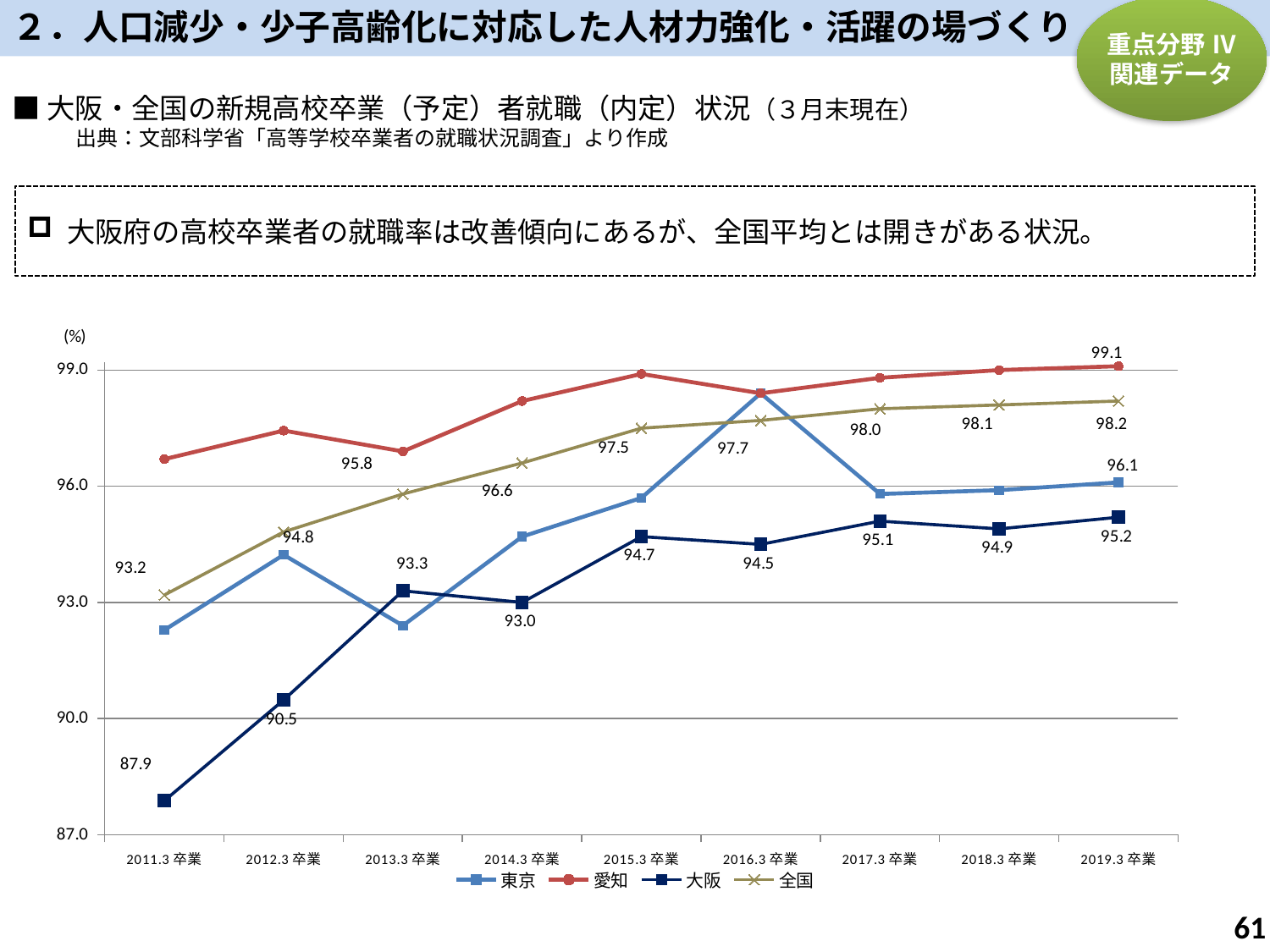
Is the value for 東京 at 2011.3 卒業 greater or less than 93.0? less Which series has the lowest value at 2011.3 卒業? 大阪 What is the value for 全国 at 2019.3 卒業? 98.2 How many series does the legend list? 4 What is the difference between 全国 and 大阪 at 2019.3 卒業? 3.0 What is the value for 大阪 at 2011.3 卒業? 87.9 What is the value for 愛知 at 2019.3 卒業? 99.1 What kind of chart is shown on the slide? line chart Does the 全国 series rise or fall from 2011.3 卒業 to 2019.3 卒業? rise What is the value for 東京 at 2019.3 卒業? 96.1 How many graduation years are plotted along the x axis? 9 Which series has the highest value at 2019.3 卒業? 愛知